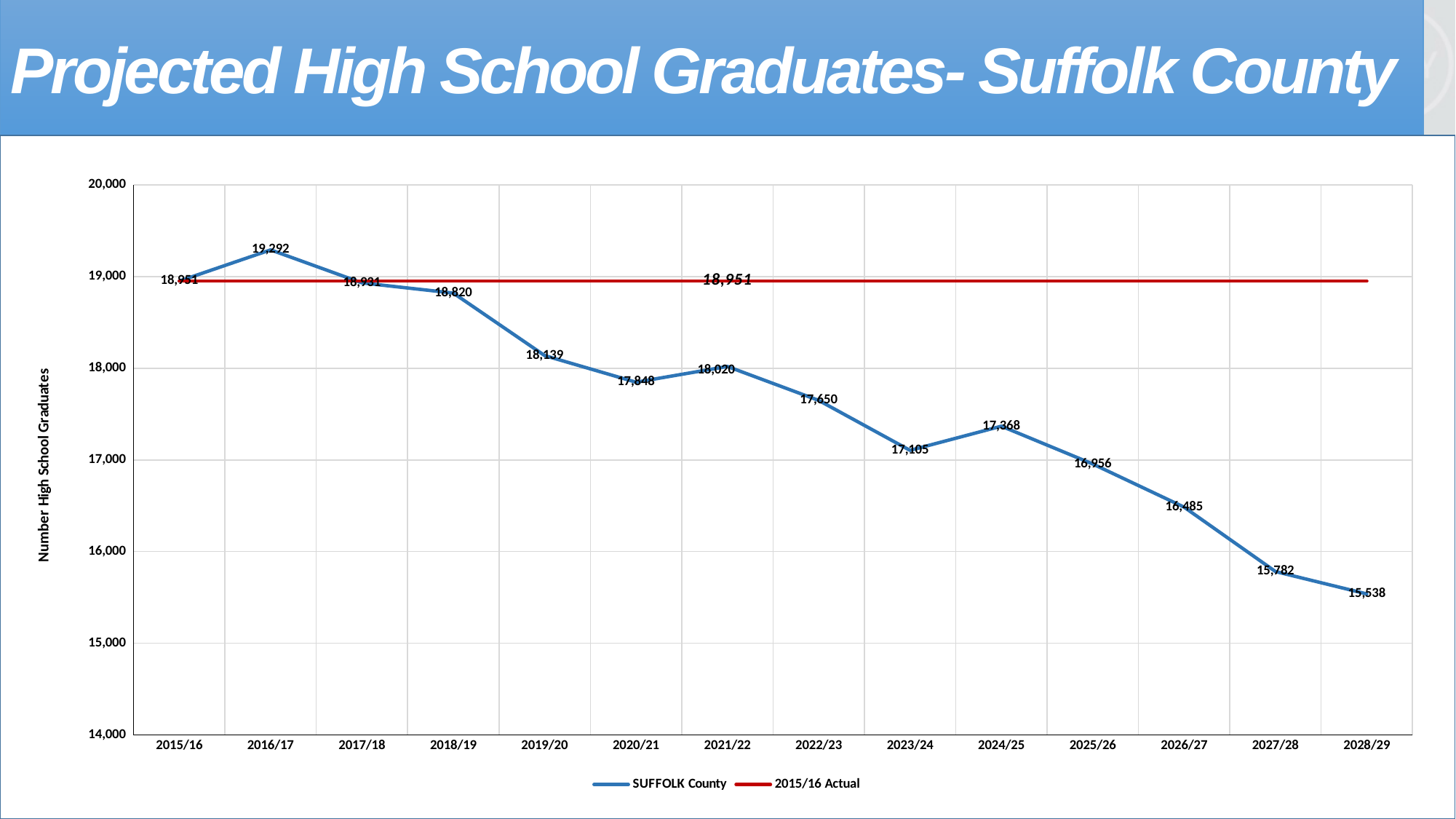
What is the projected number of high school graduates for Suffolk County in 2023/24? 17,105 What is the projected number of high school graduates for Suffolk County in 2028/29? 15,538 Is the value for 2025/26 greater or less than 17,000? less Which school year has the lowest projected number of high school graduates? 2028/29 Which year has more projected graduates, 2021/22 or 2020/21? 2021/22 What value does the red 2015/16 Actual reference line represent? 18,951 How many school years are plotted on the x axis? 14 What kind of chart is shown on the slide? line chart What is the projected number of high school graduates for Suffolk County in 2016/17? 19,292 Which school year has the highest projected number of high school graduates? 2016/17 What is the difference between the projected graduates in 2016/17 and 2028/29? 3,754 How many series does the legend list? 2